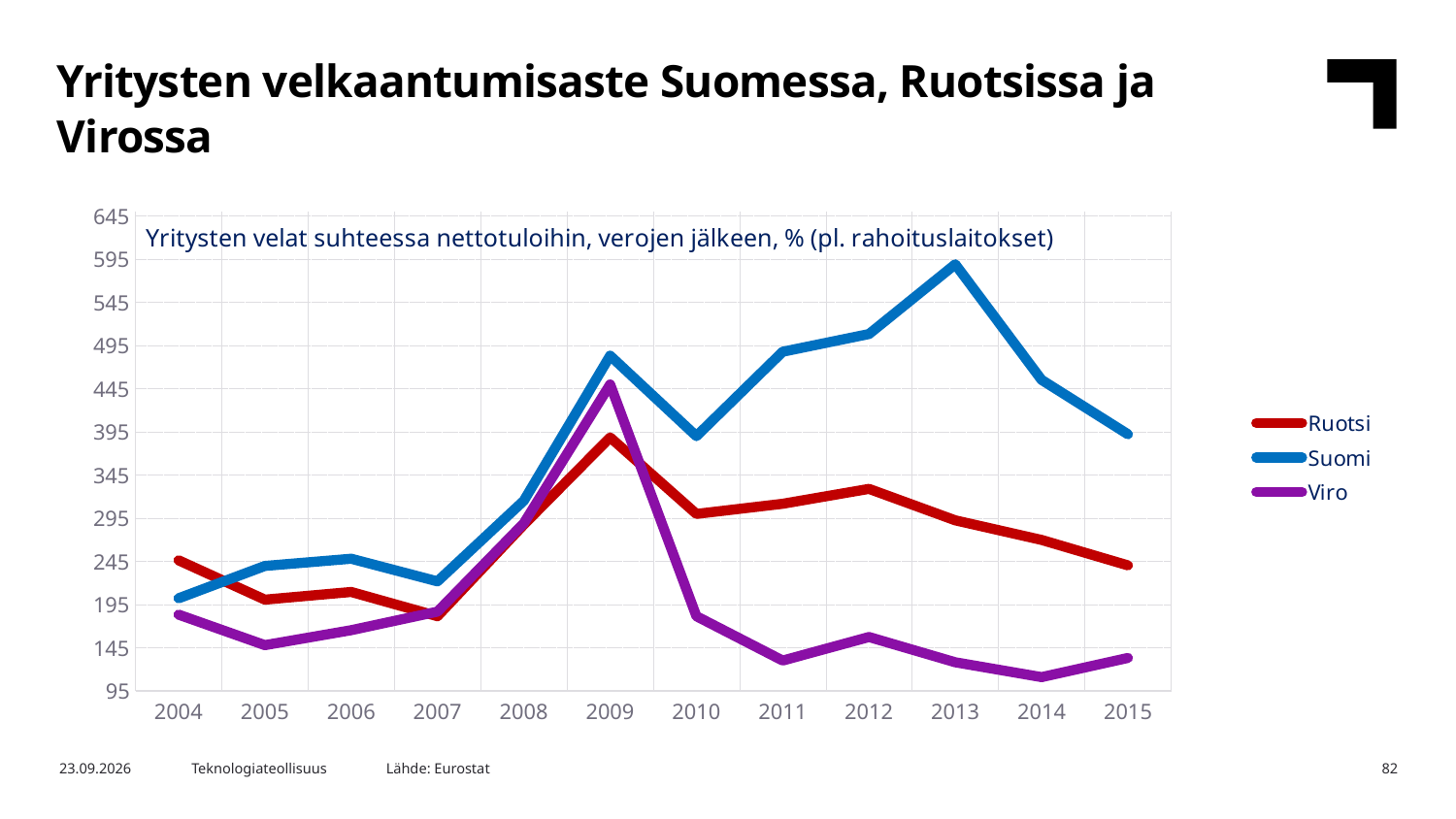
In which year does the Suomi line reach its highest value? 2013 How many series does the legend list? 3 Is the value for Viro in 2011 greater or less than 195? less What kind of chart is shown on the slide? line chart Which series has the highest value in 2015? Suomi Is the value for Ruotsi in 2012 greater or less than 295? greater Is the value for Suomi in 2013 greater or less than 545? greater How many years are shown on the x axis? 12 In which year does the Ruotsi line reach its highest value? 2009 Does the Suomi line rise or fall from 2013 to 2015? fall In which year does the Viro line reach its lowest value? 2014 Which series has the higher value in 2004, Ruotsi or Suomi? Ruotsi